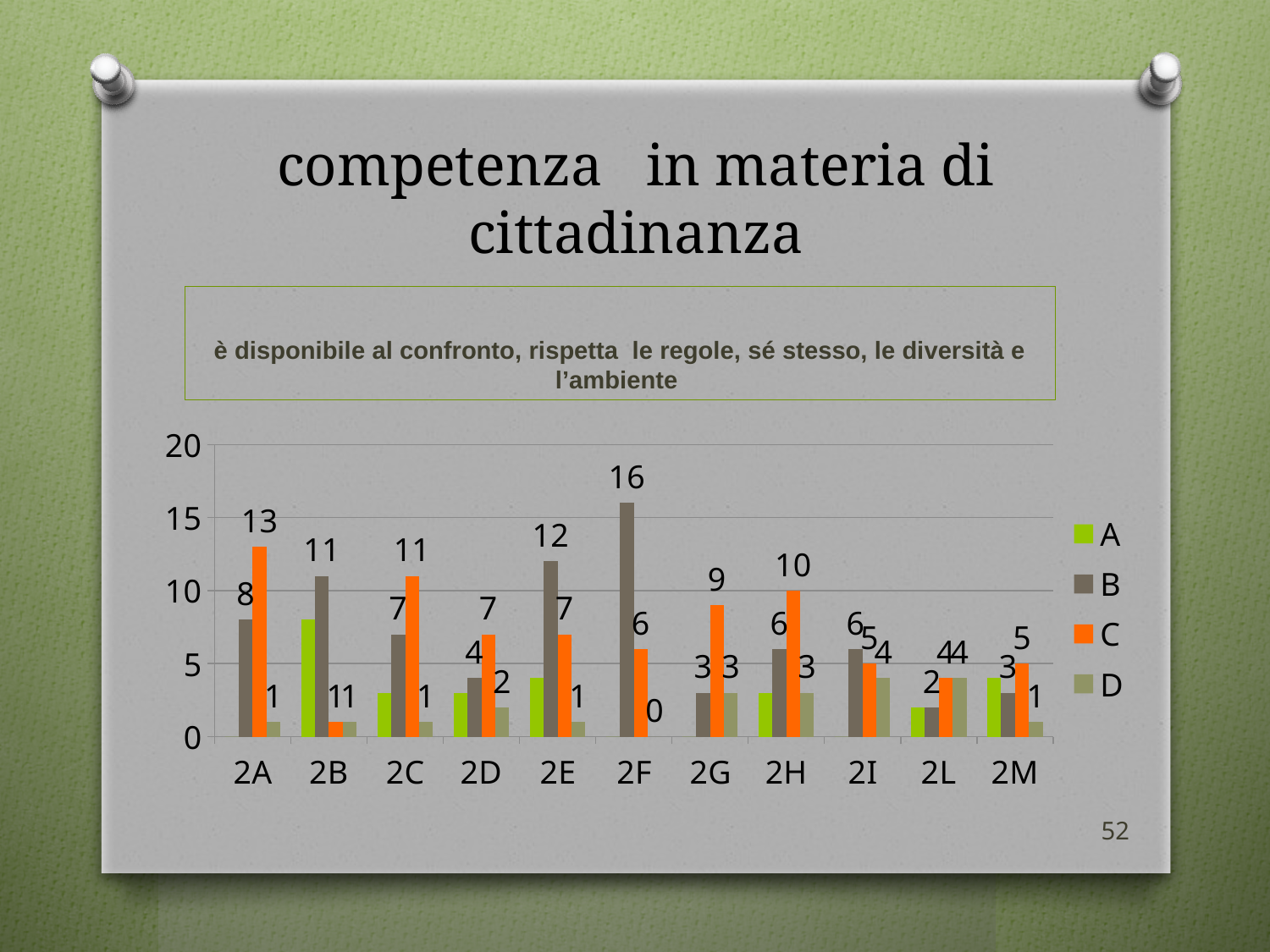
How many classes are shown along the x axis? 11 What kind of chart is shown on the slide? bar chart How many series does the legend list? 4 What is the value of series C for class 2H? 10 Is the value of series B for class 2F greater or less than 15? greater For class 2E, which is larger: series B or series C? B What is the value of series B for class 2F? 16 Which class has the highest value for series C? 2A What is the value of series C for class 2A? 13 Which class has the highest value for series B? 2F What are the entries listed in the legend? A, B, C, D What is the difference between series C and series B for class 2A? 5